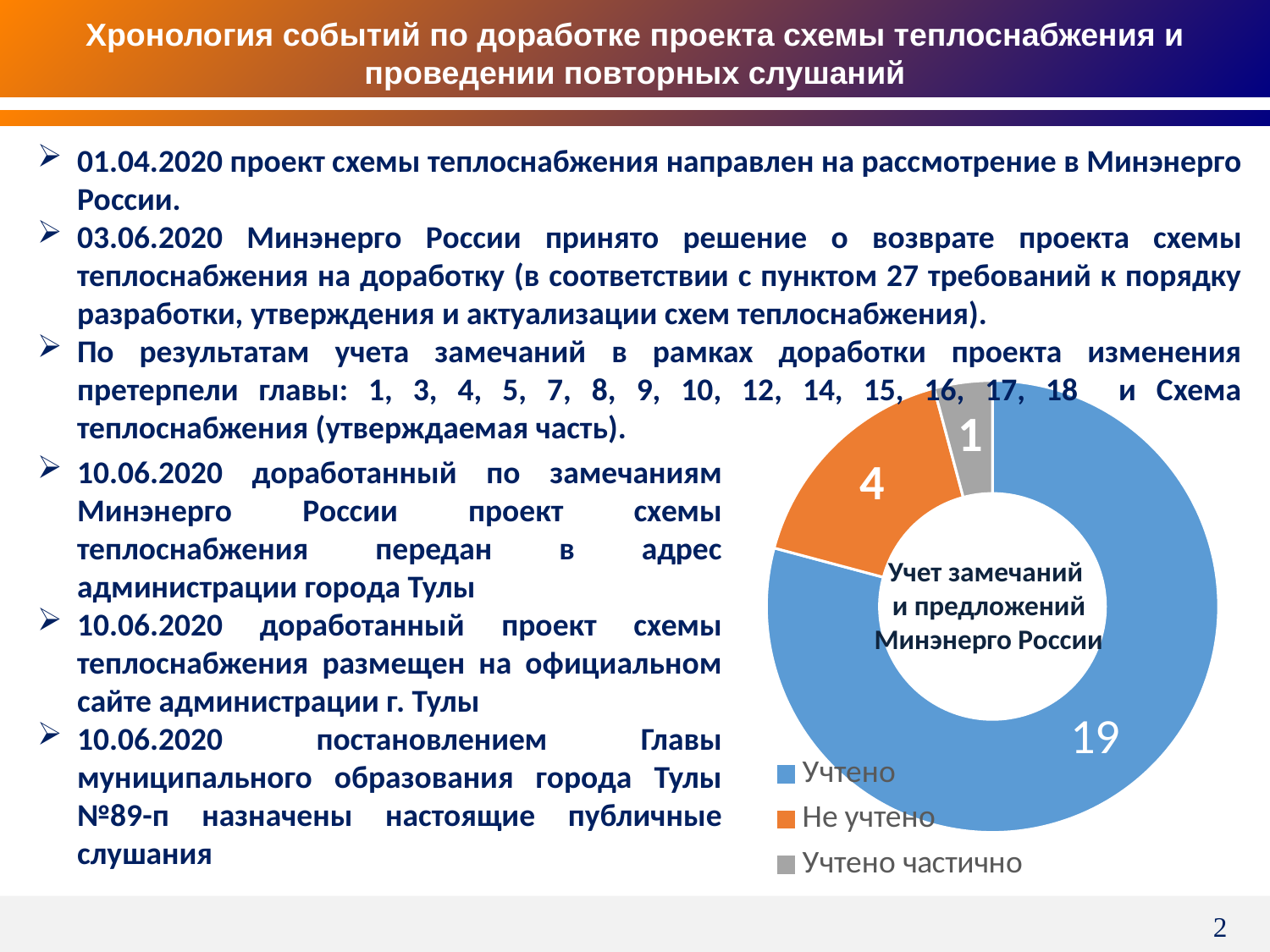
What is the value for "Не учтено" in the chart? 4 Which category has the smallest value in the chart? Учтено частично Which category has the largest value in the chart? Учтено What is the difference between the values for "Учтено" and "Не учтено"? 15 What is the difference between the values for "Не учтено" and "Учтено частично"? 3 What is the value for "Учтено" in the chart? 19 What is the value for "Учтено частично" in the chart? 1 What title is written in the centre of the chart? Учет замечаний и предложений Минэнерго России Which is larger: the value for "Не учтено" or the value for "Учтено частично"? Не учтено What is the total of all values shown in the chart? 24 What kind of chart is shown on the slide? doughnut (pie) chart How many categories does the chart show? 3